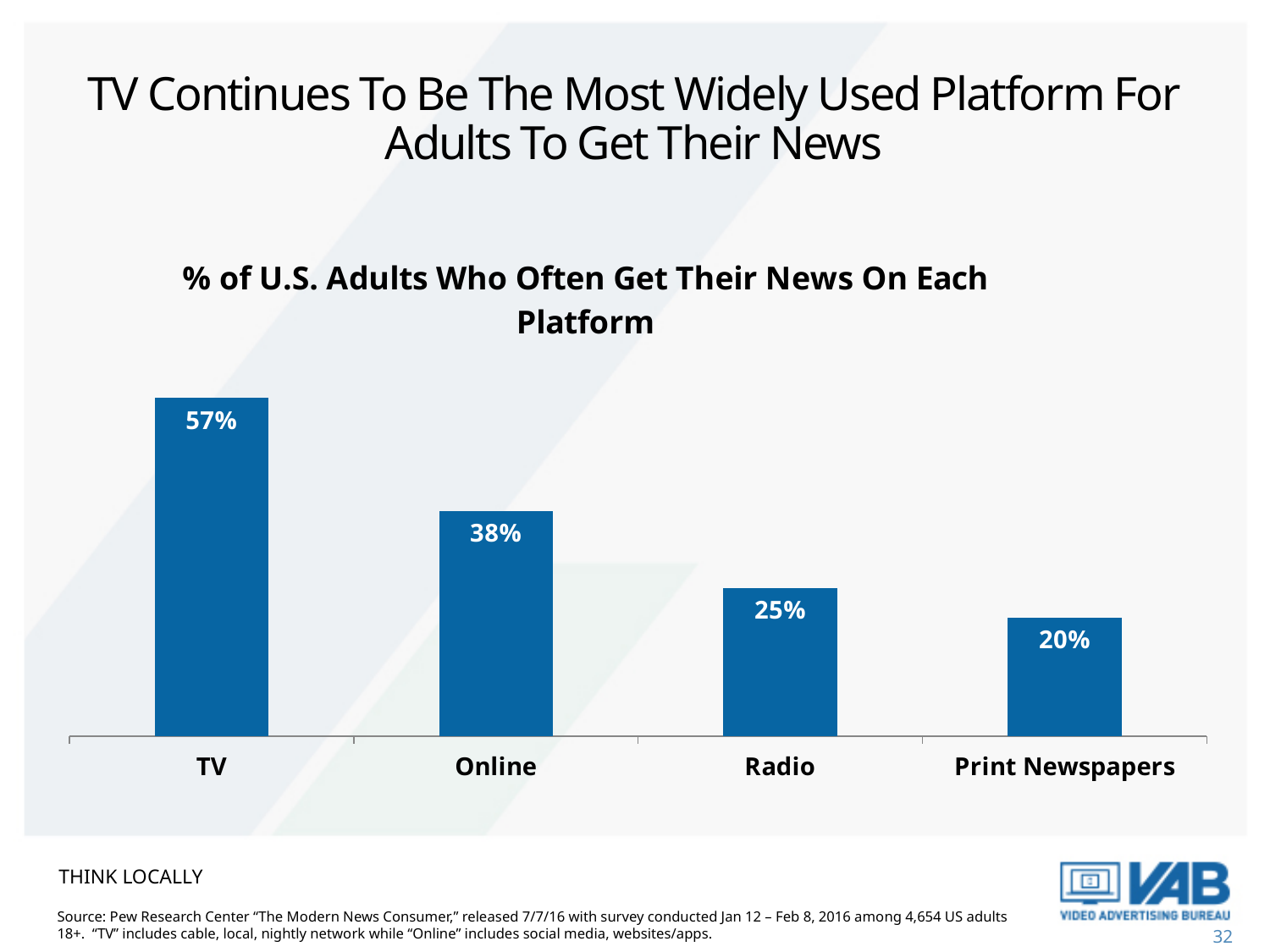
What percentage of U.S. adults often get their news on TV? 57% Which platform has the lowest percentage? Print Newspapers What is the value shown for Radio? 25% What is the difference in percentage points between TV and Online? 19 What is the title of the chart? % of U.S. Adults Who Often Get Their News On Each Platform Which is larger, the value for Online or the value for Radio? Online What is the difference in percentage points between Radio and Print Newspapers? 5 What is the value shown for Print Newspapers? 20% How many platforms are shown in the chart? 4 Which platform has the highest percentage? TV What is the value shown for Online? 38% What type of chart is shown on the slide? Bar chart